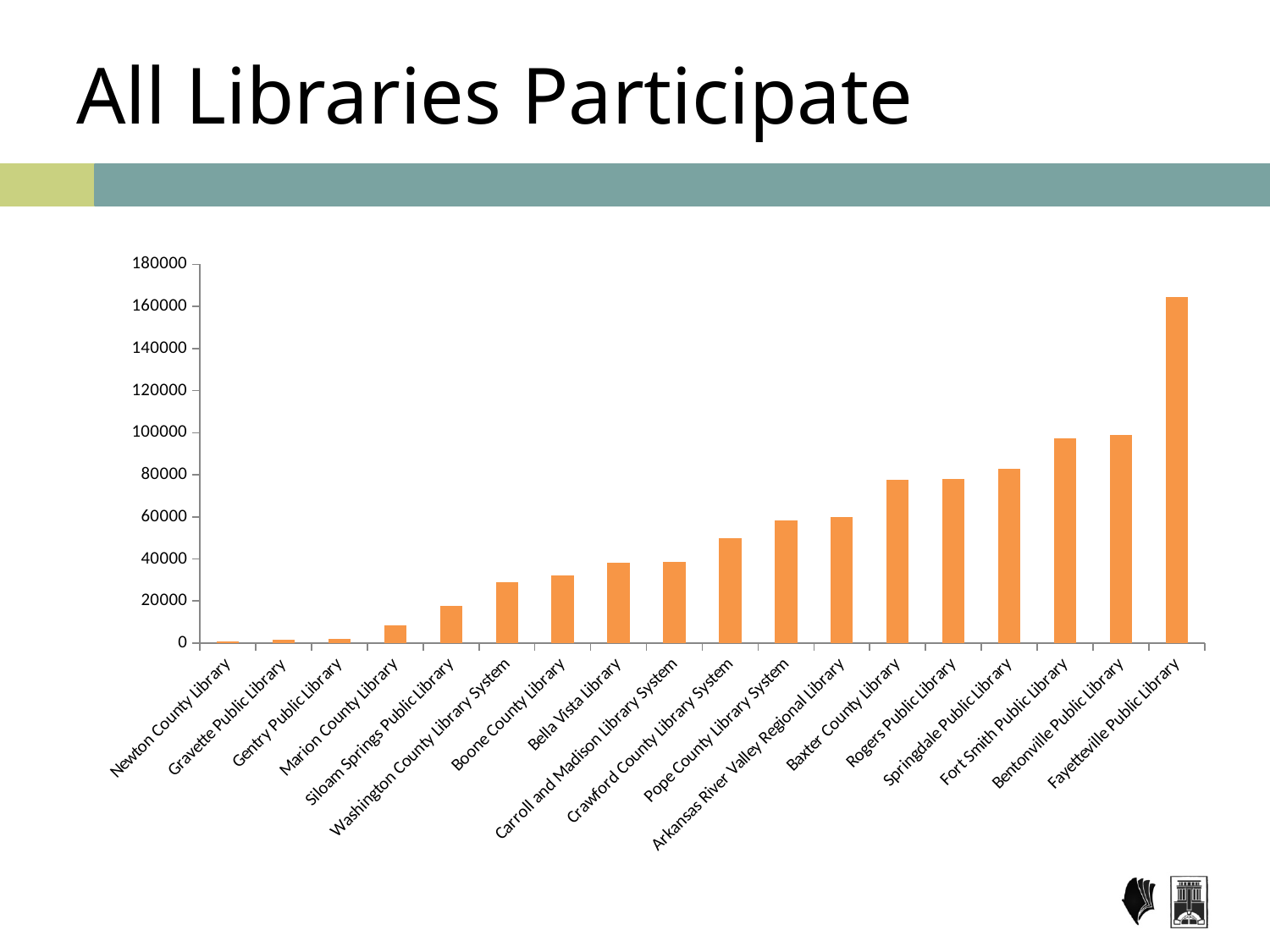
Which library has the highest value in the chart? Fayetteville Public Library Is the value for Baxter County Library greater or less than 60000? greater Which library has the lowest value in the chart? Newton County Library How many libraries are shown on the x axis of the chart? 18 Which is larger, the value for Marion County Library or the value for Newton County Library? Marion County Library What is the title of the slide containing the chart? All Libraries Participate Which is larger, the value for Fort Smith Public Library or the value for Springdale Public Library? Fort Smith Public Library Is the value for Washington County Library System greater or less than 20000? greater Is the value for Siloam Springs Public Library greater or less than 20000? less What kind of chart is shown on the slide? bar chart Do the values rise or fall moving from left to right along the x axis? rise